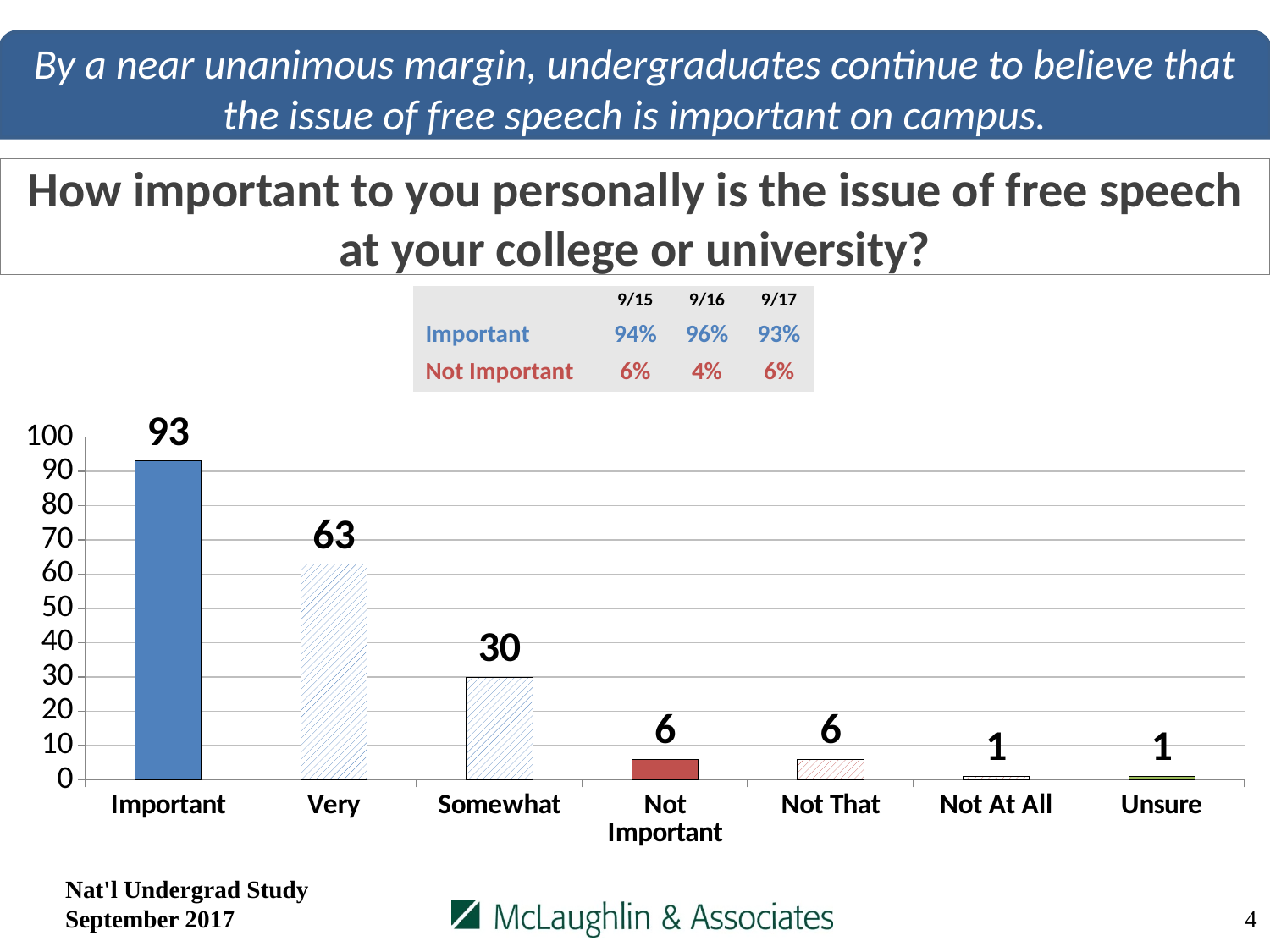
How many categories are shown on the x axis? 7 What kind of chart is shown on the slide? bar chart What is the value for Not Important? 6 What is the difference between the values for Important and Not Important? 87 Which category has the highest value? Important According to the table above the chart, what percentage said Important in 9/16? 96% What is the value for Somewhat? 30 Which is larger, the value for Somewhat or the value for Not That? Somewhat What is the difference between the values for Very and Somewhat? 33 Is the value for Very greater or less than 50? greater What is the value for Very? 63 What is the value for Important? 93